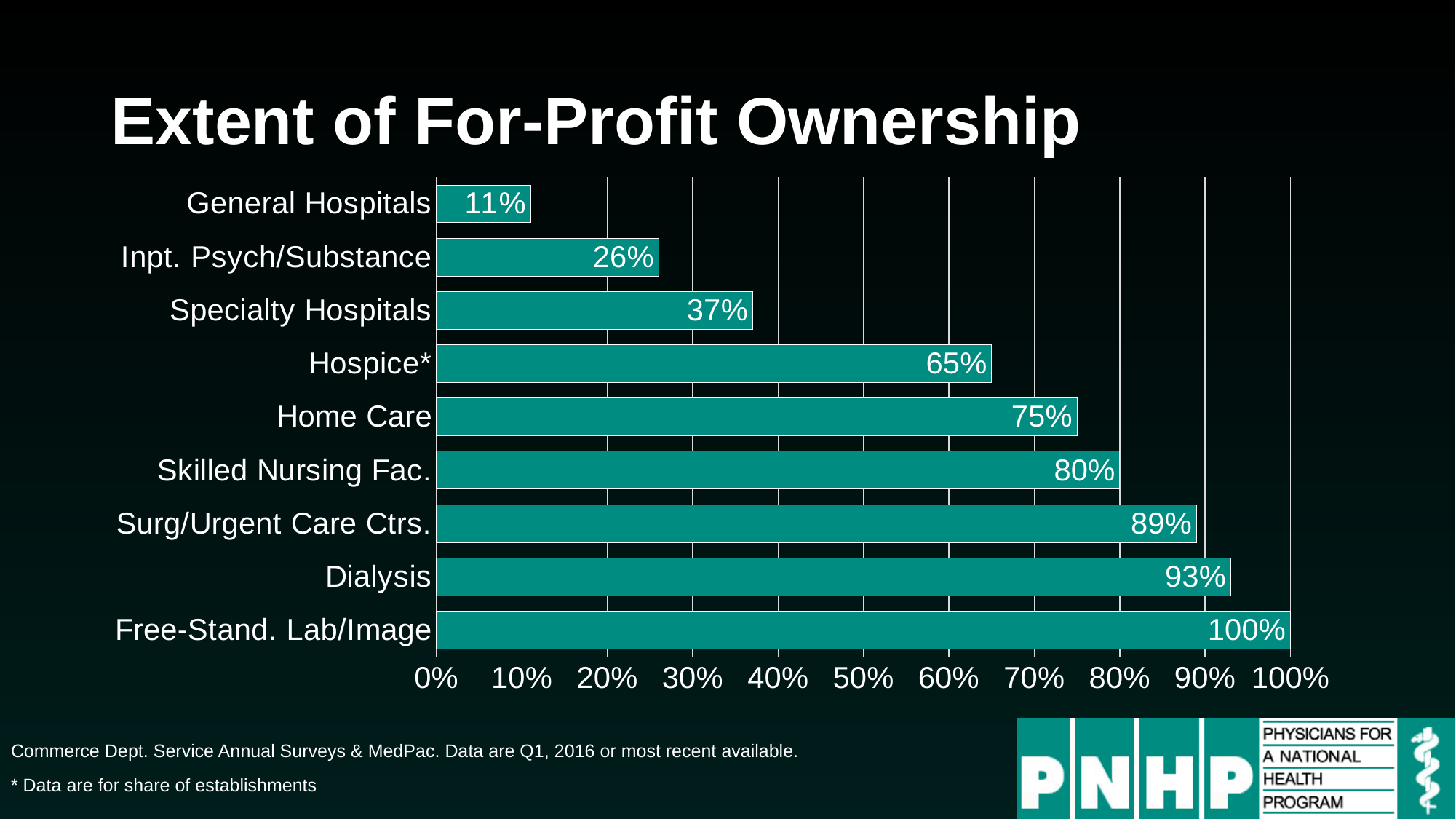
Which category has the lowest value? General Hospitals What is the title of the chart? Extent of For-Profit Ownership What is the difference between the values for Free-Stand. Lab/Image and General Hospitals? 89% How many categories are shown in the chart? 9 Which category has the highest value? Free-Stand. Lab/Image Which is larger, the value for Specialty Hospitals or the value for Surg/Urgent Care Ctrs.? Surg/Urgent Care Ctrs. What is the difference between the values for Dialysis and Home Care? 18% What kind of chart is shown on the slide? bar chart What is the value for Hospice*? 65% Is the value for Hospice* greater or less than 50%? greater What is the value for Skilled Nursing Fac.? 80% What is the value for Inpt. Psych/Substance? 26%